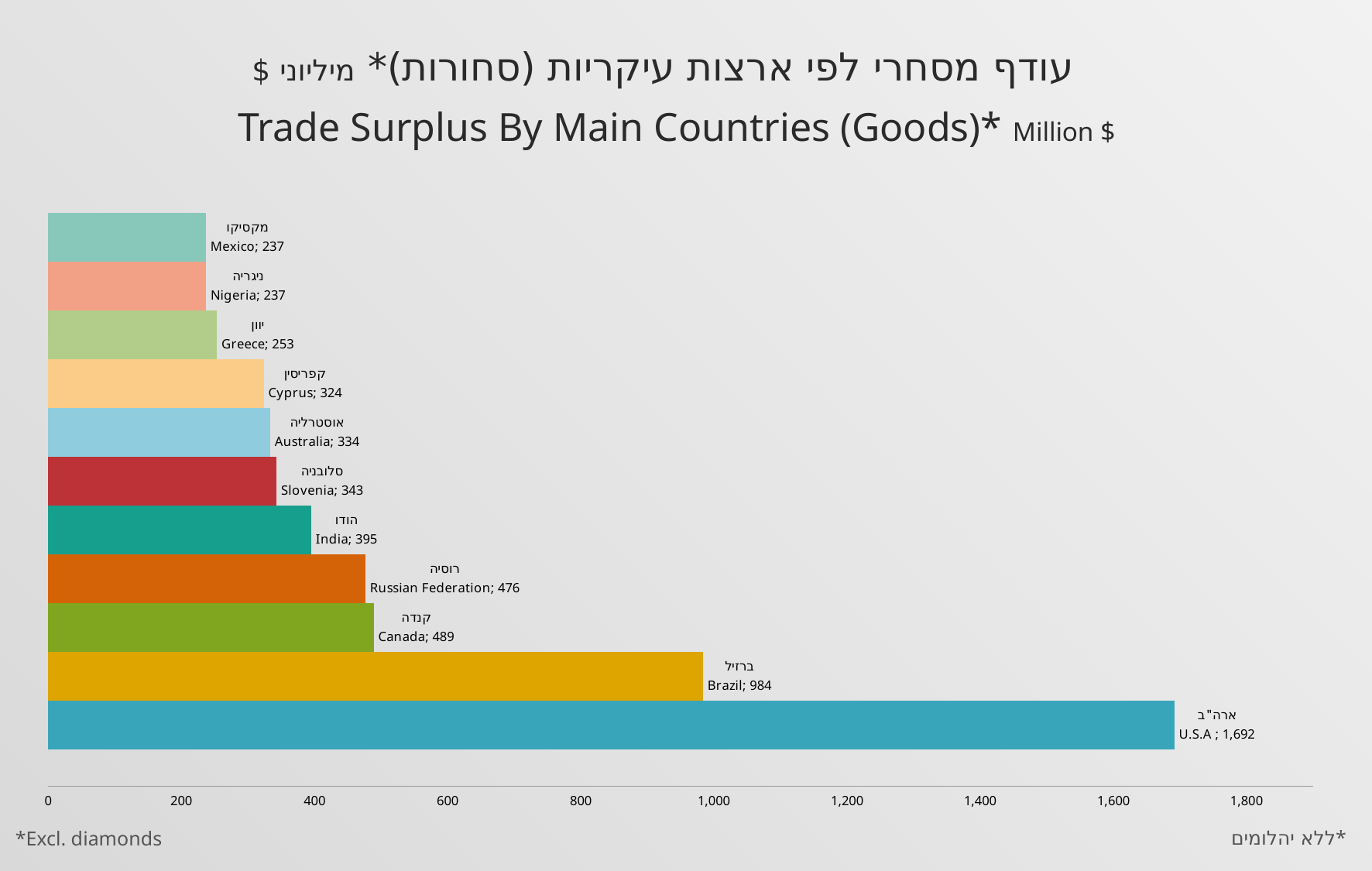
Which country has the highest trade surplus? U.S.A Which is larger, the value for Slovenia or the value for Australia? Slovenia What is the trade surplus value for the Russian Federation? 476 What is the trade surplus value for Brazil? 984 How many countries are shown in the chart? 11 Is the value for Brazil greater or less than 1,000? less Which two countries have the same value of 237? Mexico and Nigeria What kind of chart is shown on the slide? bar chart What is the English title of the chart? Trade Surplus By Main Countries (Goods)* What is the difference between the values for U.S.A and Brazil? 708 What is the trade surplus value for Cyprus? 324 What is the difference between the values for Canada and India? 94